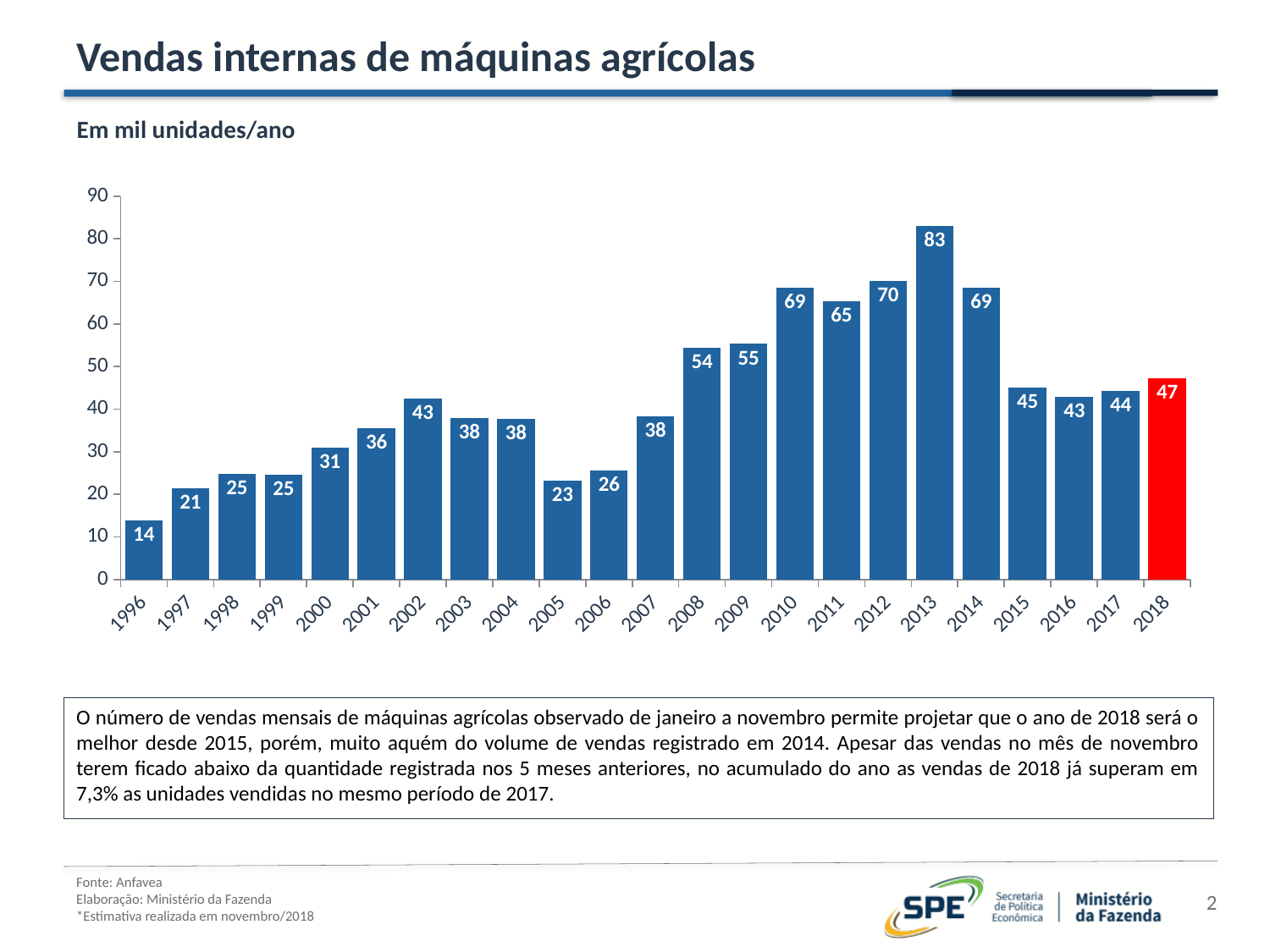
Which bar is coloured red instead of blue? 2018 Which year has the lowest value? 1996 How many years are shown on the x axis? 23 Do the values rise or fall from 2013 to 2016? Fall Which year has the highest value? 2013 What is the difference between the values for 2014 and 2018? 22 What is the value for 2018? 47 What is the value for 2013? 83 Which is larger, the value for 2017 or the value for 2018? 2018 What is the value for 1996? 14 What kind of chart is shown on the slide? Bar chart Is the value for 2012 greater or less than 60? greater